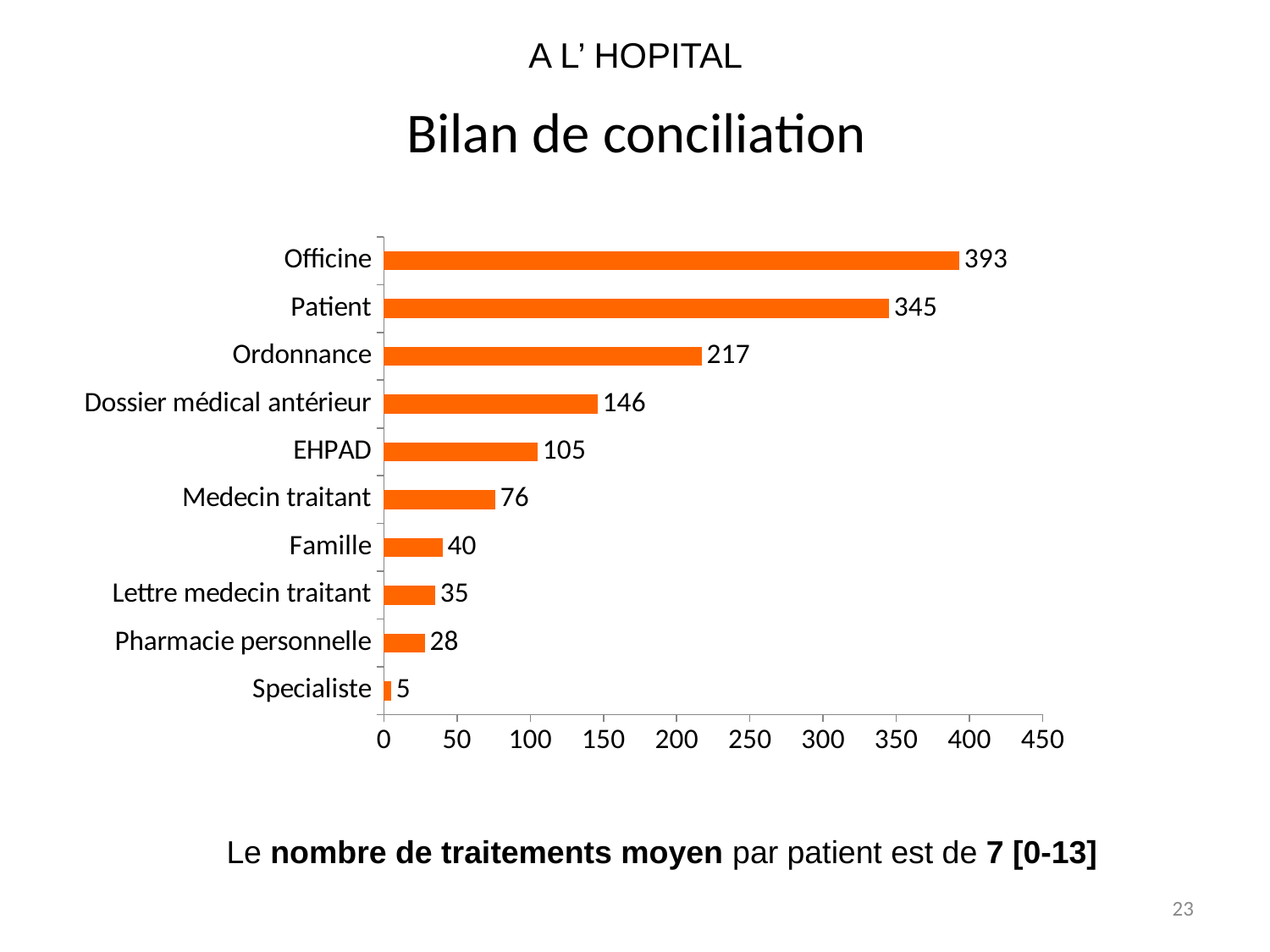
What is the difference between the values for Ordonnance and Dossier médical antérieur? 71 Which is larger, the value for Famille or the value for Lettre medecin traitant? Famille What kind of chart is shown on the slide? bar chart What colour are the bars in the chart? orange What is the value for EHPAD? 105 What is the value for Officine? 393 What is the difference between the values for Officine and Patient? 48 Which category has the lowest value? Specialiste Is the value for Medecin traitant greater or less than 100? less Which category has the highest value? Officine How many categories are shown in the chart? 10 What is the value for Pharmacie personnelle? 28